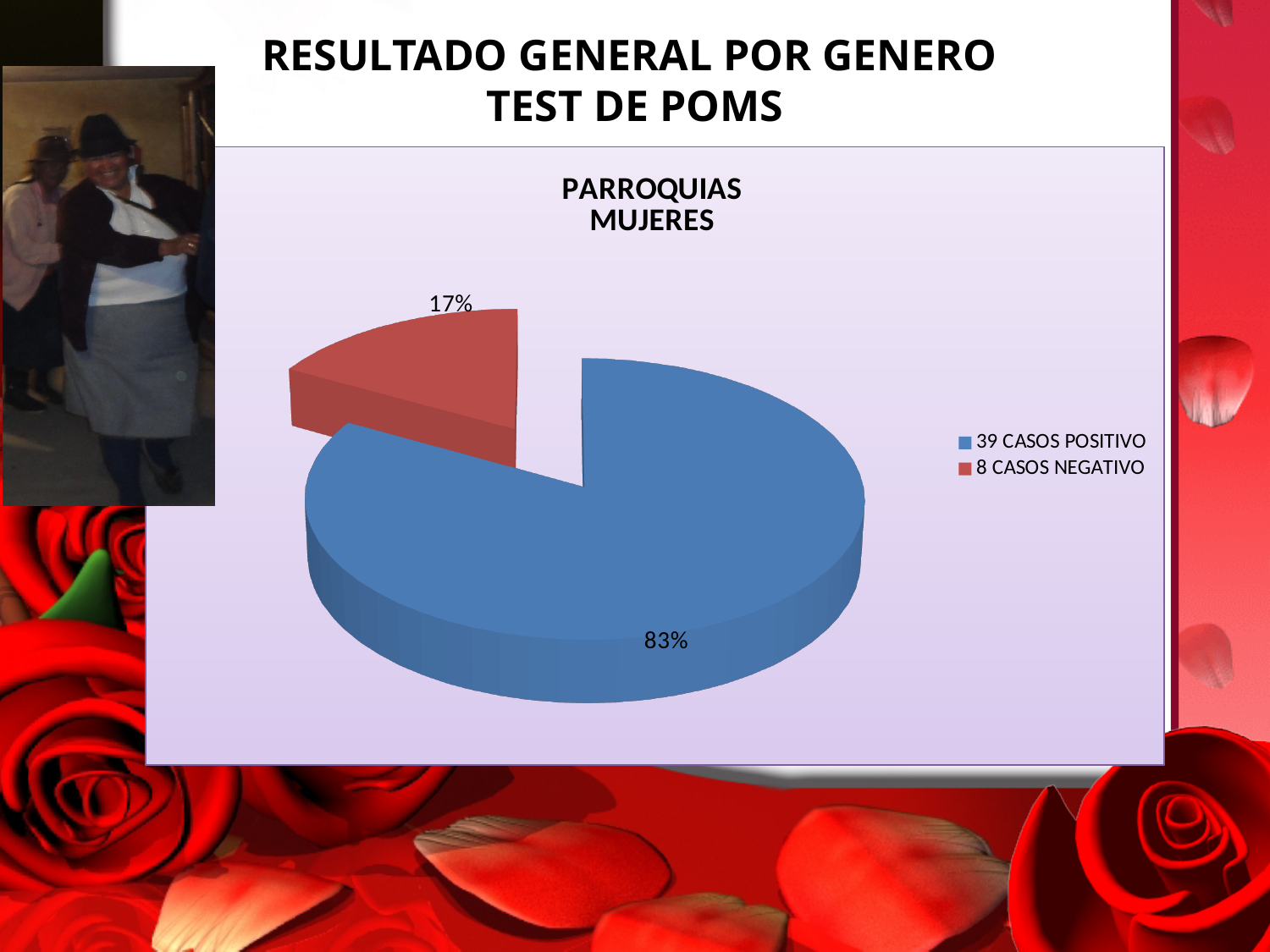
How many slices does the pie chart have? 2 What is the difference in percentage points between the 39 CASOS POSITIVO slice and the 8 CASOS NEGATIVO slice? 66 What kind of chart is shown on the slide? pie chart Which category has the smallest slice of the pie? 8 CASOS NEGATIVO What percentage share does the slice for 8 CASOS NEGATIVO have? 17% What percentage share does the slice for 39 CASOS POSITIVO have? 83% What colour is the slice for 8 CASOS NEGATIVO? red Which slice is larger, 39 CASOS POSITIVO or 8 CASOS NEGATIVO? 39 CASOS POSITIVO How many entries does the legend list? 2 Which category has the largest slice of the pie? 39 CASOS POSITIVO What is the title of the chart? PARROQUIAS MUJERES